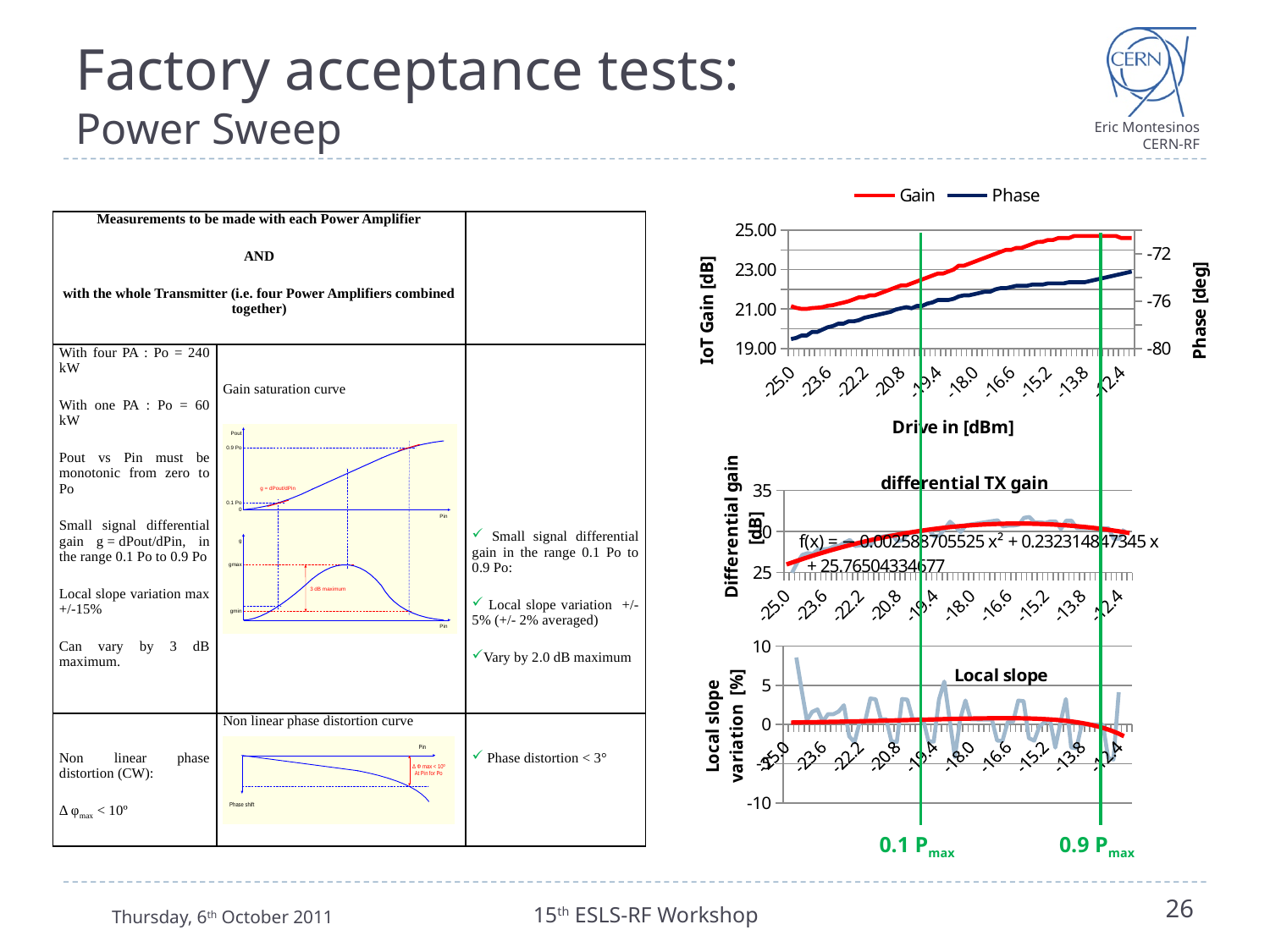
What is the title of the middle chart on the right? differential TX gain What kind of chart is the top chart on the right (Gain and Phase)? line chart What is the title of the bottom chart on the right? Local slope In the top chart on the right, is the Gain value at a drive of -12.4 dBm greater or less than 23.00? greater In the top chart on the right, what are the two series named in the legend? Gain and Phase In the top chart on the right, does the Phase series rise or fall along the x axis? rise In the top chart on the right, is the Phase value at a drive of -25.0 dBm greater or less than -76? less In the top chart on the right, how many series does the legend list? 2 How many charts are shown on the right-hand side of the slide? 3 In the top chart on the right, does the Gain series rise or fall as the drive increases along the x axis? rise